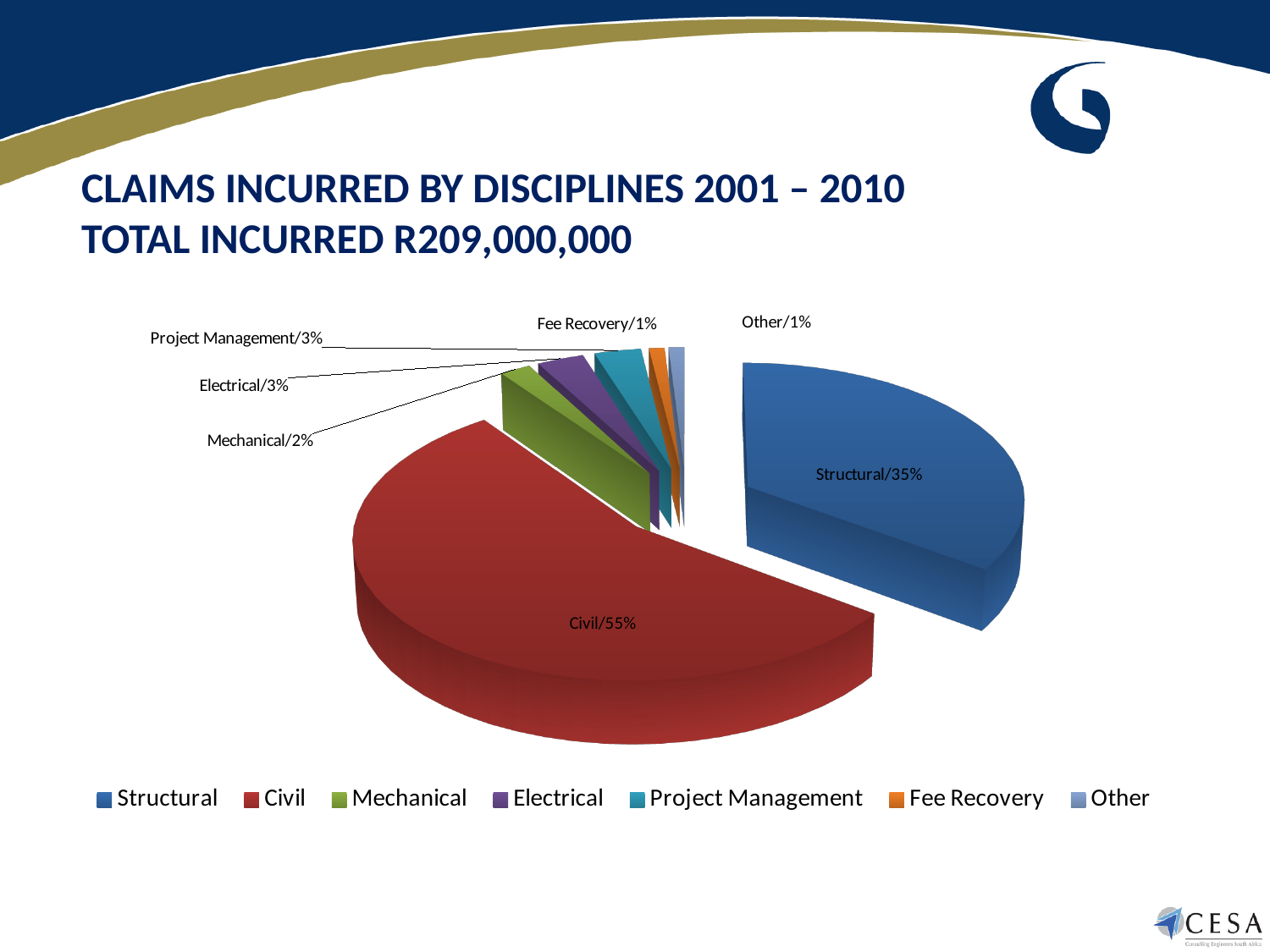
What share of claims incurred is attributed to Civil? 55% What share of claims incurred is attributed to Structural? 35% What type of chart is shown on the slide? Pie chart What percentage is shown for Mechanical? 2% What is the difference in percentage points between the Civil and Structural shares? 20 What percentage is shown for Fee Recovery? 1% How many disciplines (slices) are shown in the pie chart? 7 What percentage is shown for Project Management? 3% Which discipline has the largest share of claims incurred? Civil Which has a larger share, Structural or Electrical? Structural How many entries does the legend list? 7 What total incurred amount is stated in the chart title? R209,000,000